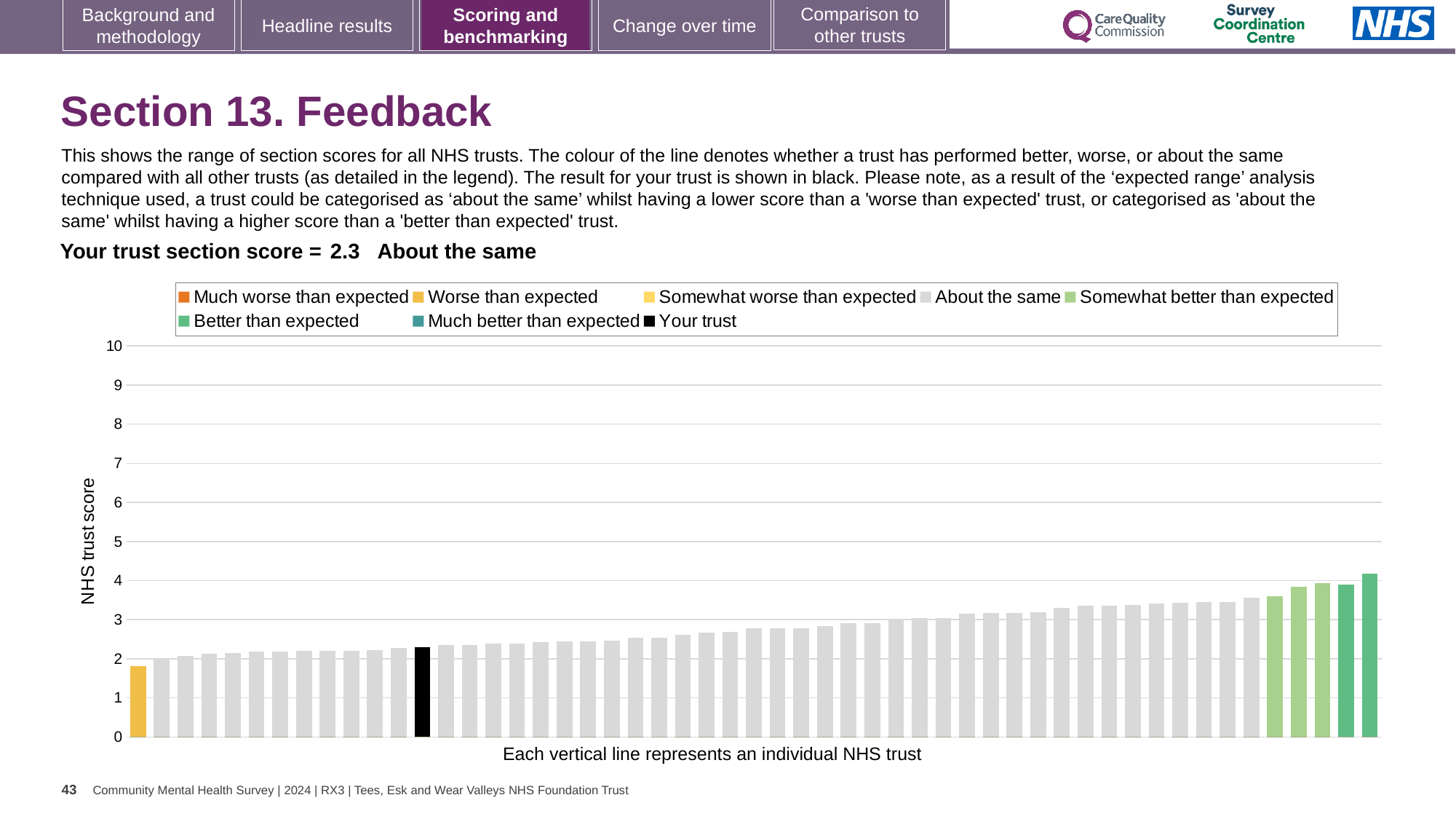
What is the label of the y axis? NHS trust score Do the bar values rise or fall from left to right along the x axis? rise Is the value of the highest bar greater or less than 5? less Is the value of the lowest (leftmost) bar greater or less than 2? less How many entries does the chart legend list? 8 Which legend category does the highest-scoring trust belong to? Better than expected Which is larger: the value for your trust or the value of the rightmost bar? the rightmost bar Is the value for your trust greater or less than 2? greater Which legend category does the lowest-scoring trust belong to? Worse than expected What is the section score for your trust shown on the slide? 2.3 What kind of chart is shown on the slide? bar chart